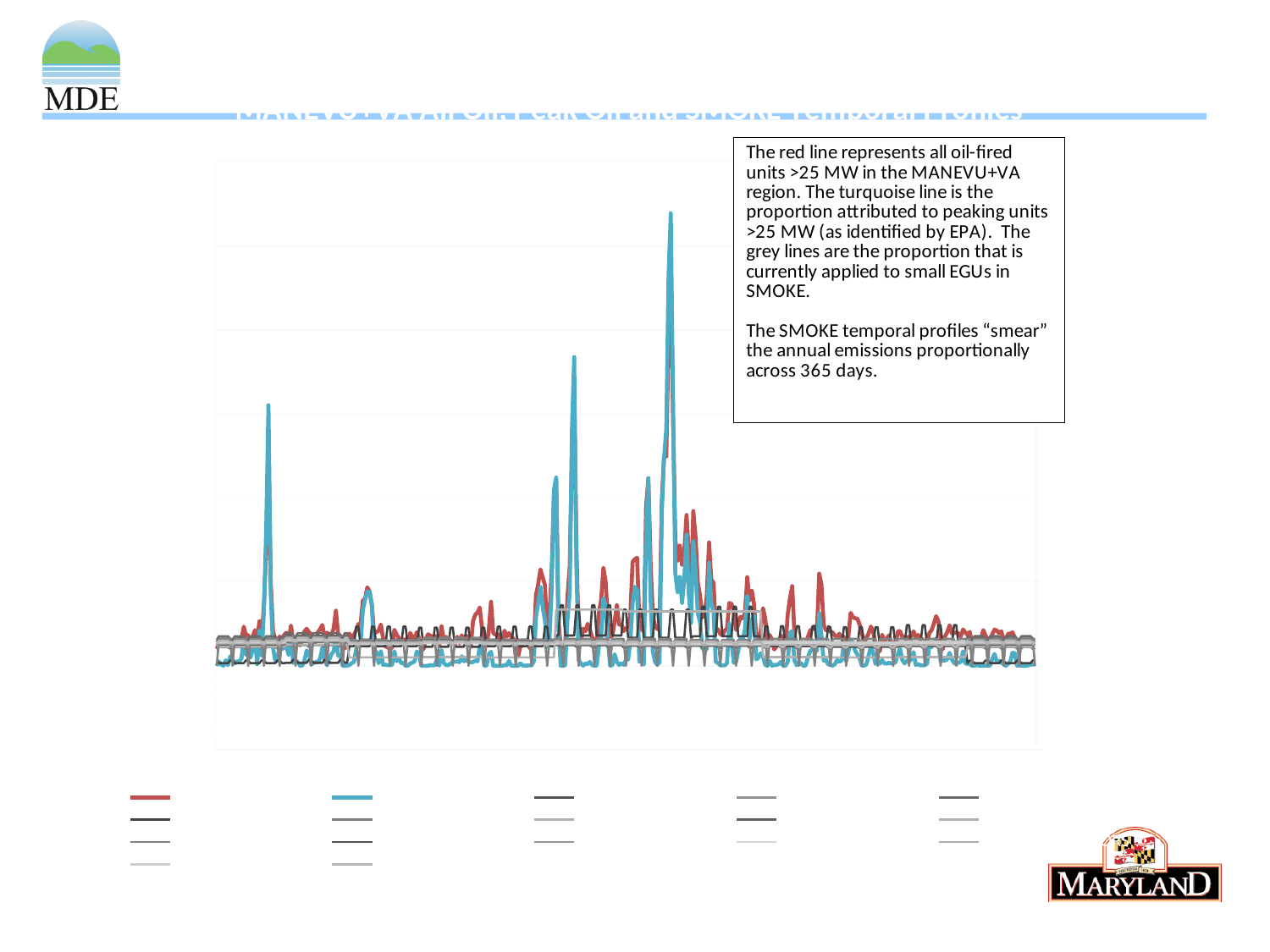
According to the text box, what do the grey lines on the chart represent? the proportion currently applied to small EGUs in SMOKE What kind of chart is shown on the slide? line chart Which coloured line reaches the highest peak on the chart? the turquoise line Which line reaches a higher peak, the red line or the turquoise line? the turquoise line According to the text box, what does the red line on the chart represent? all oil-fired units >25 MW in the MANEVU+VA region